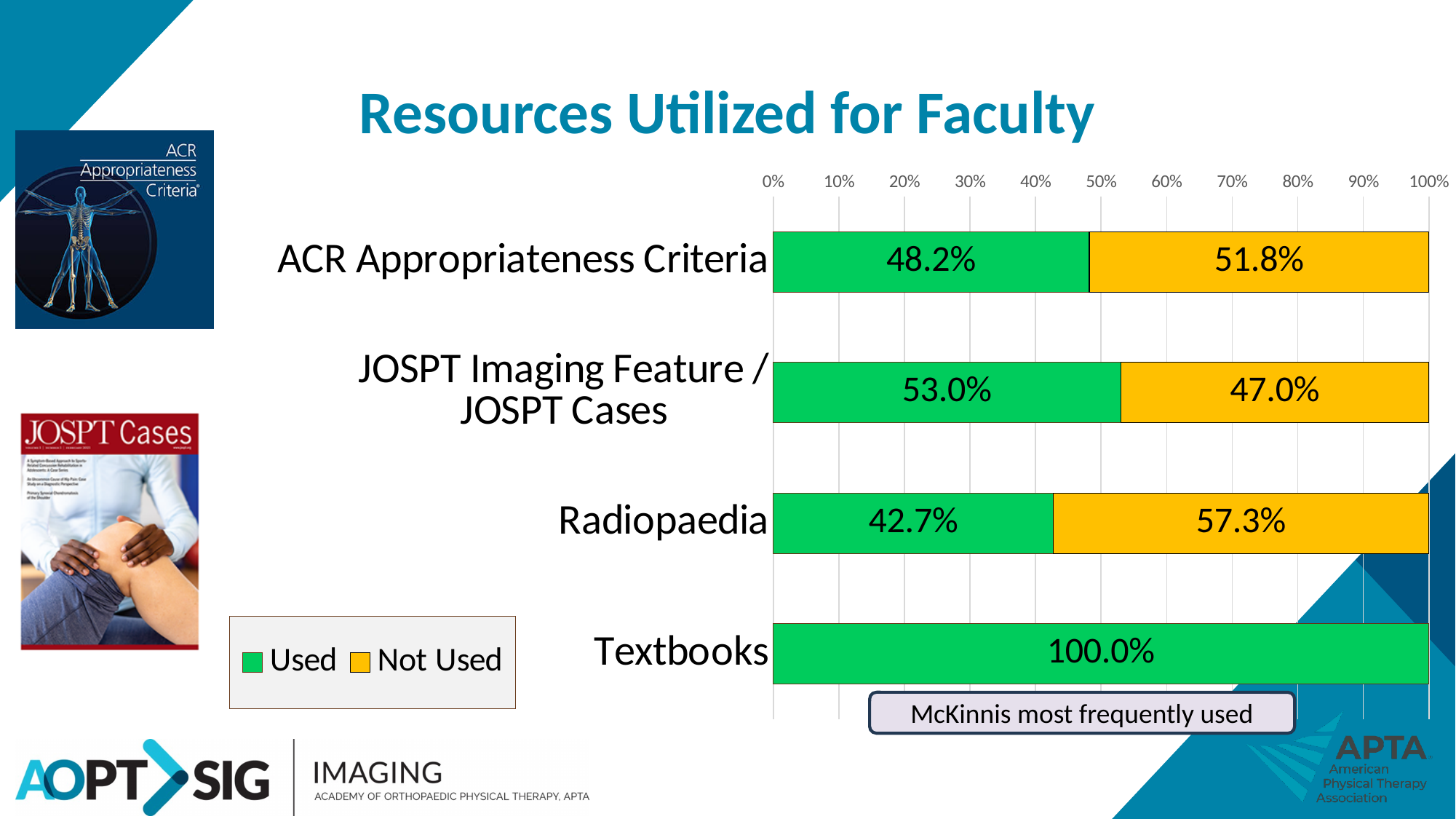
What percentage of faculty used the ACR Appropriateness Criteria? 48.2% How many series does the legend list? 2 Which resource has the lowest 'Used' percentage? Radiopaedia What is the 'Used' value for JOSPT Imaging Feature / JOSPT Cases? 53.0% What is the 'Used' value for Textbooks? 100.0% What kind of chart is shown on the slide? Stacked bar chart Is the 'Used' value larger for JOSPT Imaging Feature / JOSPT Cases or for ACR Appropriateness Criteria? JOSPT Imaging Feature / JOSPT Cases Which resource has the highest 'Used' percentage? Textbooks What is the difference between the 'Not Used' and 'Used' values for Radiopaedia? 14.6% What colour represents 'Not Used' in the chart? Yellow What is the 'Not Used' value for Radiopaedia? 57.3% How many resources are shown in the chart? 4